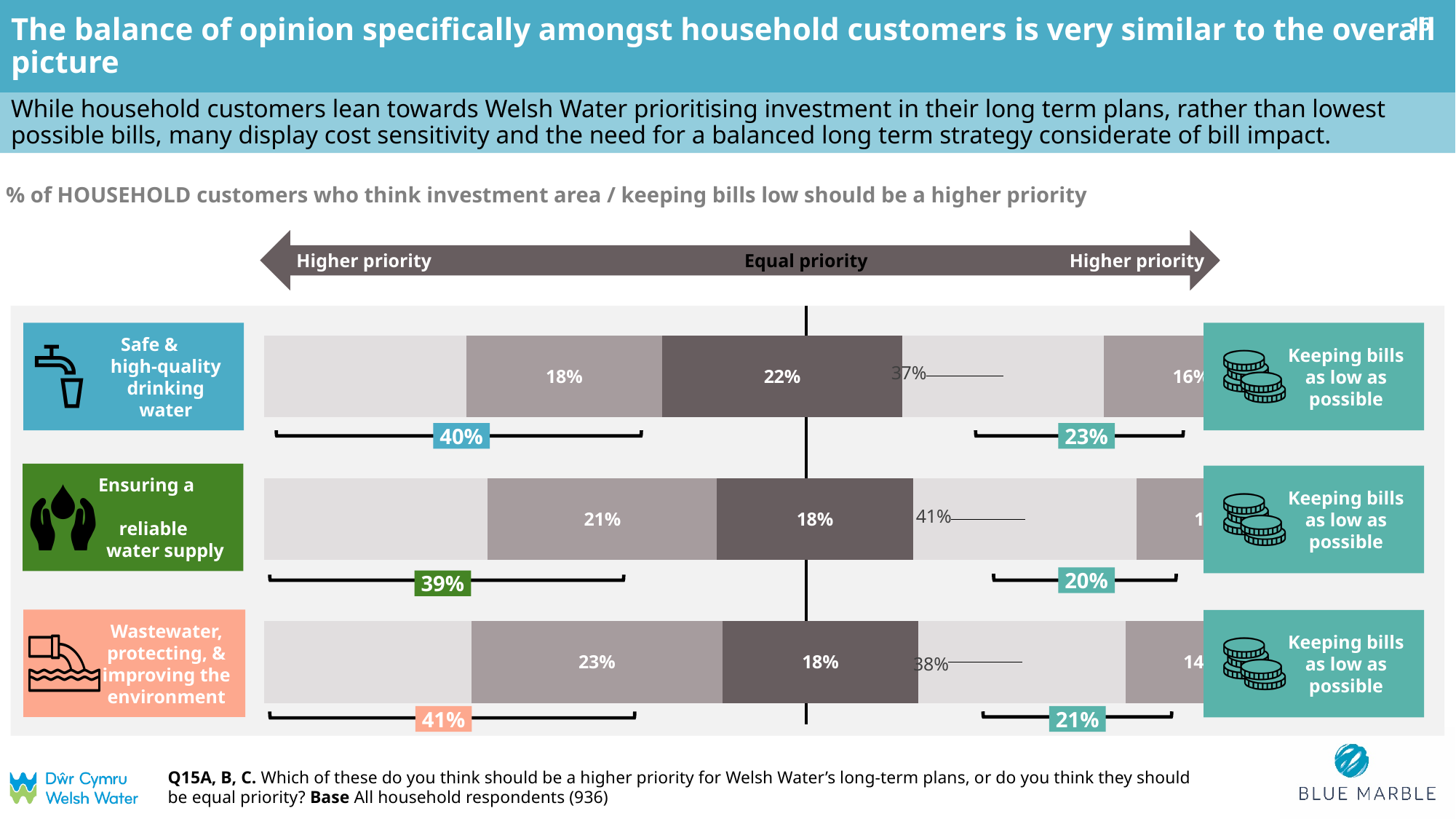
What is the bracketed net percentage of household customers who think keeping bills low should be a higher priority than ensuring a reliable water supply? 20% Which investment area has the highest bracketed net percentage of household customers saying it should be a higher priority than keeping bills low? Wastewater, protecting, & improving the environment (41%) For wastewater, protecting & improving the environment, which is larger: the net percentage prioritising investment or the net percentage prioritising keeping bills low? Net percentage prioritising investment (41%) What label appears at the centre of the arrow above the chart? Equal priority What kind of chart is used on this slide? Bar chart (diverging stacked bar chart) For safe & high-quality drinking water, what is the difference between the net percentage prioritising investment (40%) and the net percentage prioritising keeping bills low (23%)? 17 percentage points What is the base (number of respondents) for the chart? All household respondents (936) What percentage of household customers think safe & high-quality drinking water should be a higher priority than keeping bills low (the bracketed net figure)? 40% What percentage of household customers think wastewater, protecting & improving the environment and keeping bills low should be equal priority? 18% How many investment areas are shown in the chart? 3 Which investment area has the lowest bracketed net percentage of household customers saying keeping bills low should be the higher priority? Ensuring a reliable water supply (20%) What percentage of household customers think safe & high-quality drinking water and keeping bills low should be equal priority? 22%